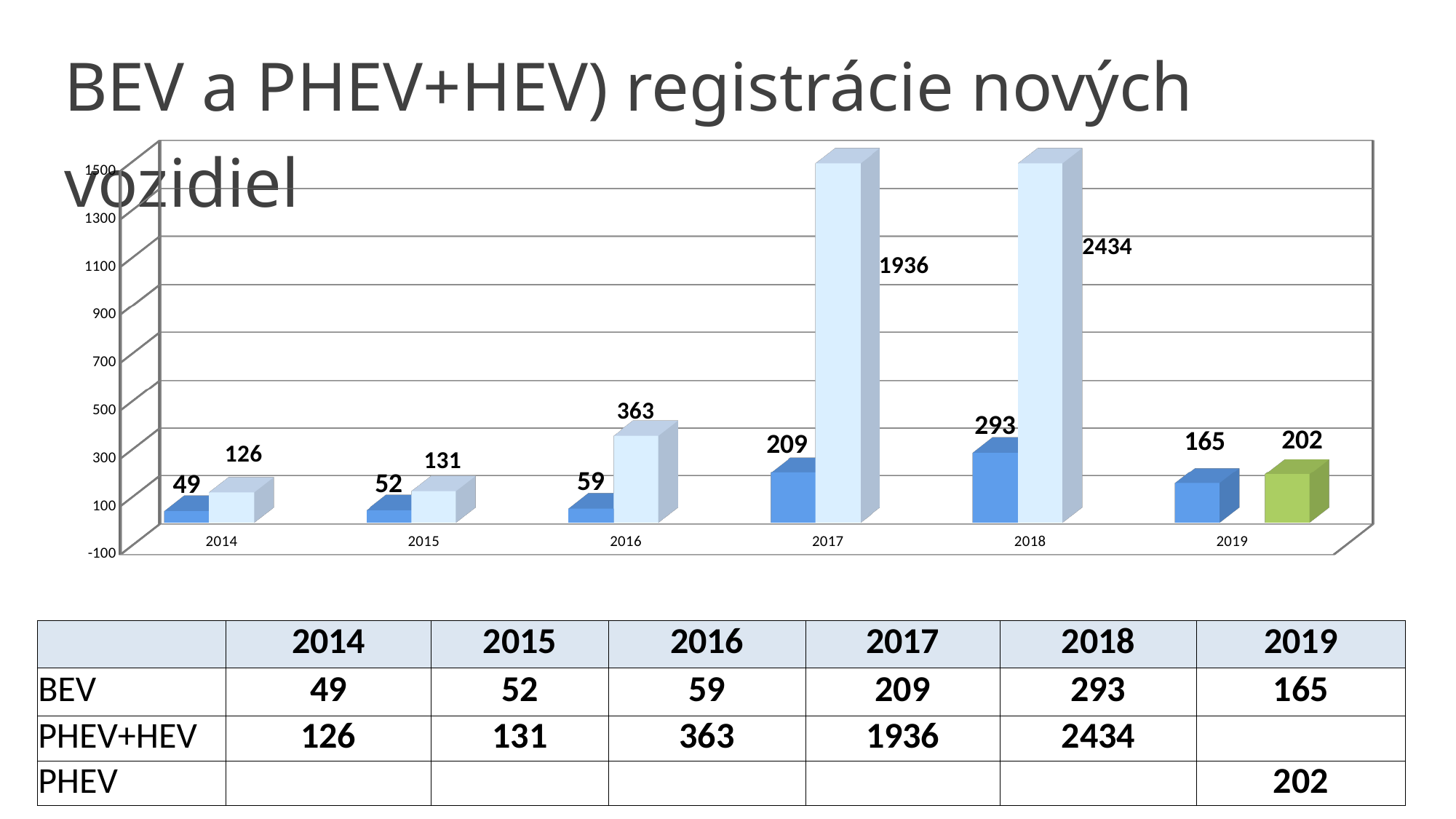
In which year is the PHEV+HEV value highest? 2018 Do the BEV values rise or fall from 2014 to 2018? rise What is the value for PHEV+HEV in 2016? 363 In which year is the BEV value lowest? 2014 How many years are shown on the x axis of the chart? 6 What is the difference between the BEV values for 2018 and 2017? 84 What is the value for BEV in 2017? 209 What is the difference between the PHEV+HEV values for 2018 and 2017? 498 What kind of chart is shown on the slide? bar chart Is the PHEV+HEV value for 2017 greater or less than 1500? greater What is the value for PHEV in 2019? 202 Which is larger, the BEV value for 2018 or the BEV value for 2019? 2018